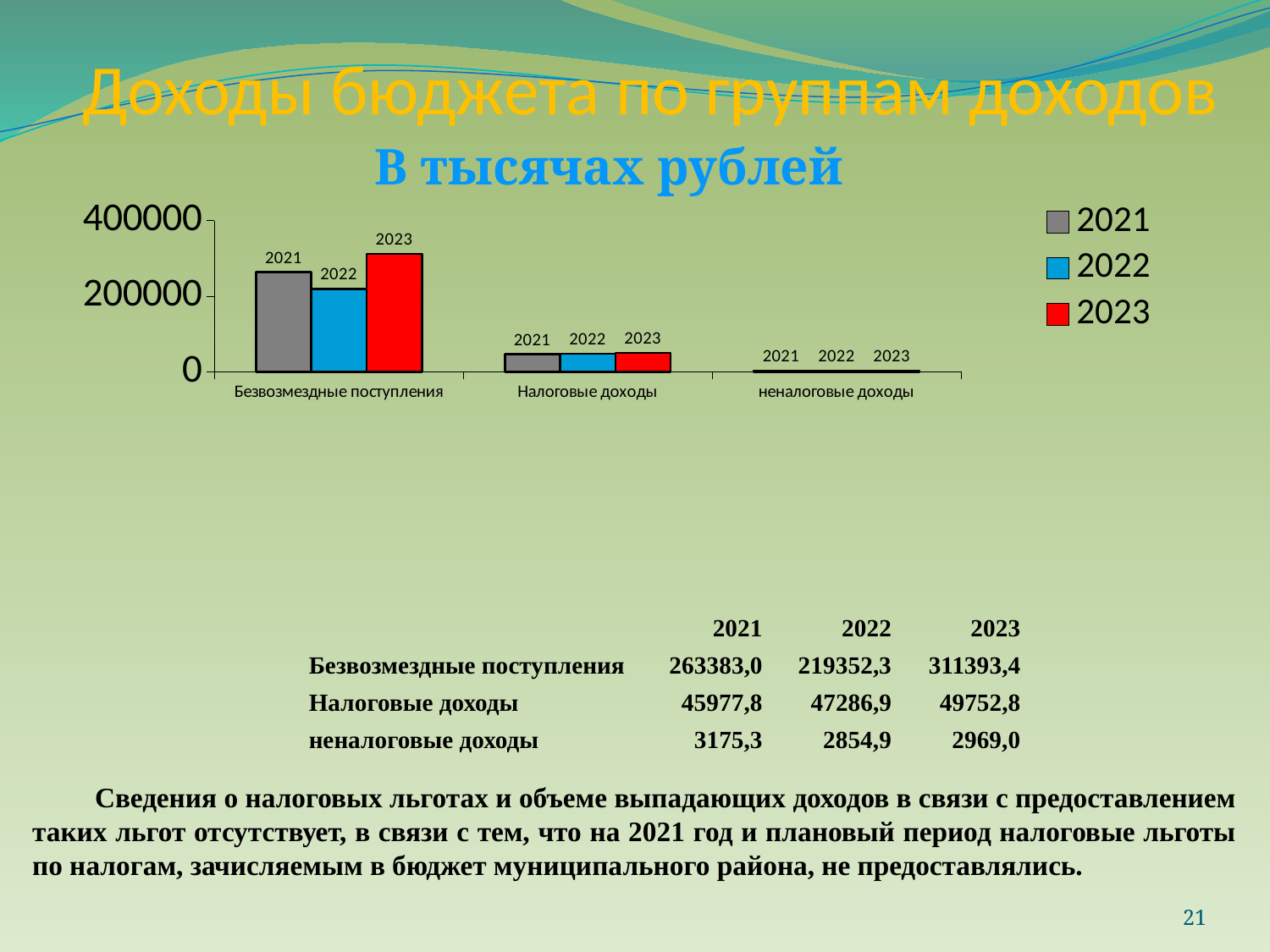
What colour represents the 2023 series in the chart? red What kind of chart is shown on the slide? bar chart Is the 2022 value for Налоговые доходы greater or less than 200000? less What is the value for Налоговые доходы in 2023, as given in the table on the slide? 49752,8 Is the 2023 value for Безвозмездные поступления greater or less than 200000? greater Which category has the highest values in the chart? Безвозмездные поступления What is the value for Безвозмездные поступления in 2021, as given in the table on the slide? 263383,0 How many series does the chart legend list? 3 What is the subtitle above the chart indicating the units? В тысячах рублей Which category has the lowest values in the chart? неналоговые доходы How many categories are shown on the x axis of the chart? 3 For Безвозмездные поступления, which year has the larger value, 2022 or 2023? 2023